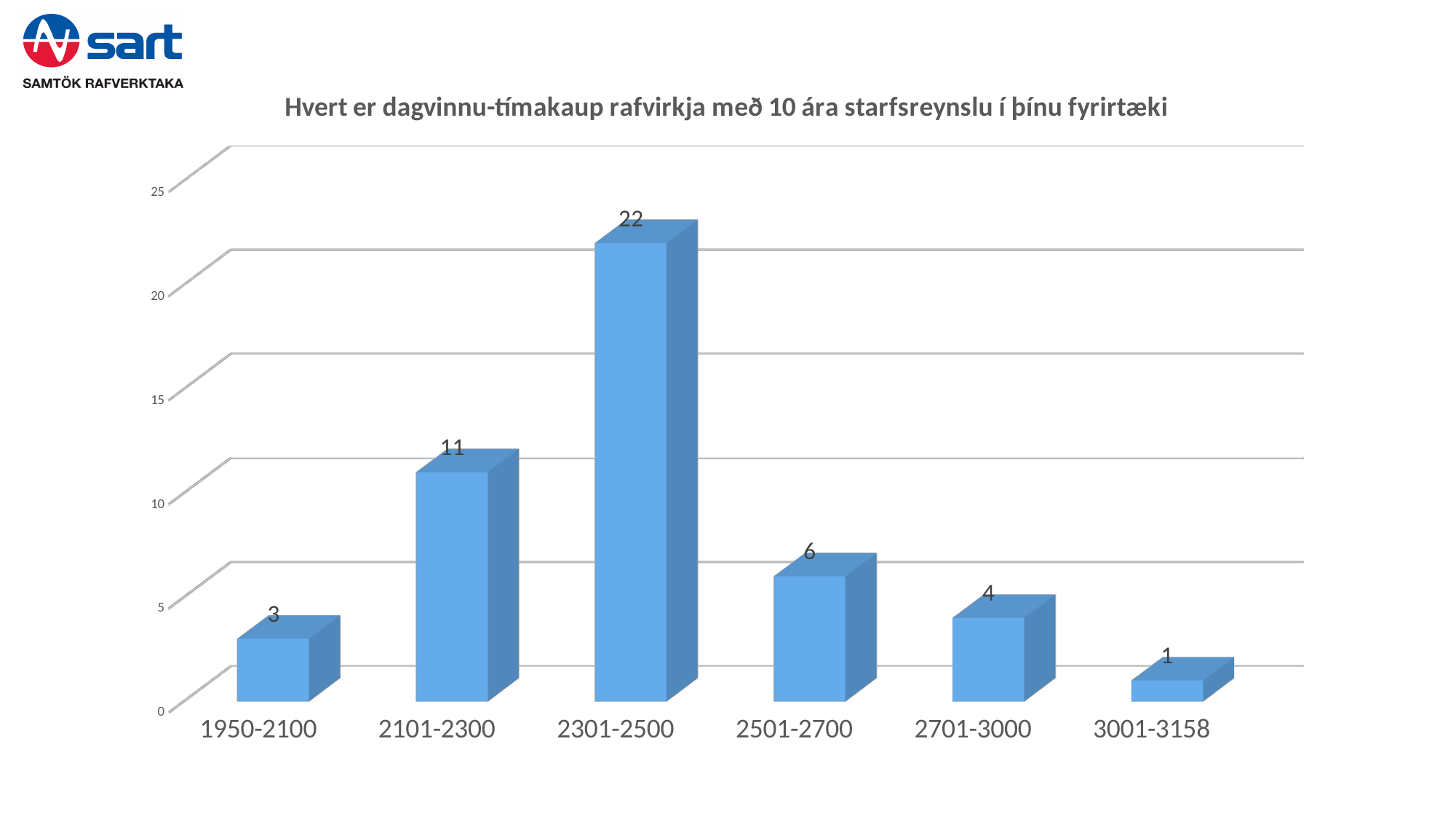
What is the difference between the values for 2301-2500 and 2101-2300? 11 What is the value for the 2301-2500 category? 22 What kind of chart is shown on the slide? bar chart Is the value for 2101-2300 greater or less than 10? greater What is the title of the chart? Hvert er dagvinnu-tímakaup rafvirkja með 10 ára starfsreynslu í þínu fyrirtæki Which is larger, the value for 2101-2300 or the value for 2501-2700? 2101-2300 Which category has the highest value? 2301-2500 How many categories are shown on the x axis? 6 What is the value for the 1950-2100 category? 3 What is the value for the 2701-3000 category? 4 Which category has the lowest value? 3001-3158 What is the difference between the values for 2501-2700 and 2701-3000? 2